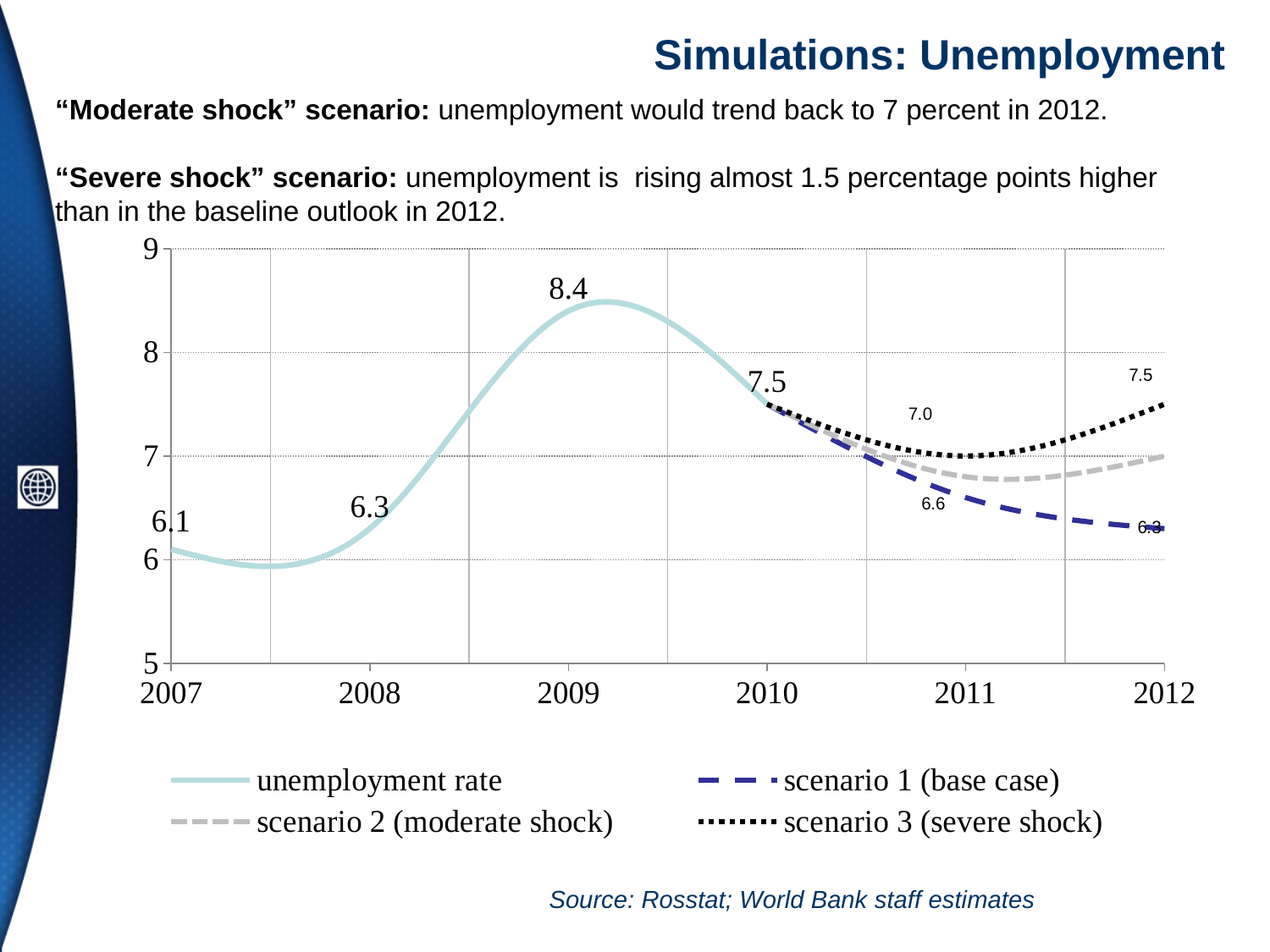
In 2012, which is higher: scenario 3 (severe shock) or scenario 1 (base case)? scenario 3 (severe shock) Does the unemployment rate line rise or fall between 2009 and 2010? fall What is the difference between the unemployment rate labelled for 2009 and the one labelled for 2008? 2.1 How many series does the legend list? 4 What value is labelled for scenario 3 (severe shock) in 2012? 7.5 In which year does the unemployment rate line reach its highest labelled value? 2009 Which series is drawn as a black dotted line according to the legend? scenario 3 (severe shock) What is the unemployment rate value labelled for 2007? 6.1 What kind of chart is shown on the slide? line chart Is the value for scenario 1 (base case) in 2012 greater or less than 7? less What is the unemployment rate value labelled for 2010? 7.5 What is the unemployment rate value labelled for 2009? 8.4